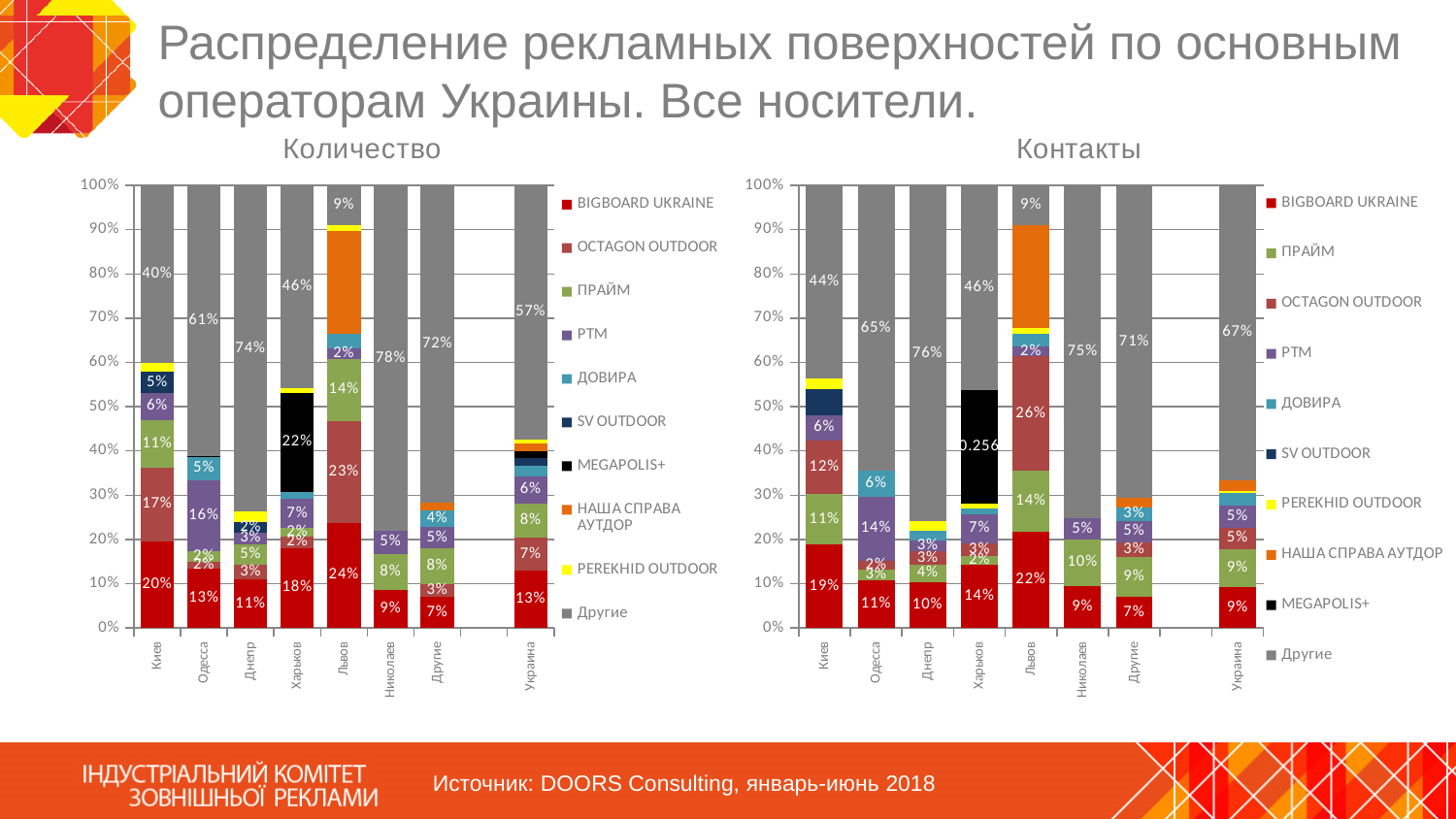
On the 'Количество' chart, what is the BIGBOARD UKRAINE value for Львов? 24% On the 'Количество' chart, what is the value of the 'Другие' segment for Киев? 40% On the 'Количество' chart, which city has the largest 'Другие' segment? Николаев On the 'Контакты' chart, what is the 'Другие' value for Днепр? 76% On the 'Контакты' chart, which category has the smallest 'Другие' segment? Львов On the 'Количество' chart, what is the difference between the 'Другие' values for Николаев and Киев? 38 percentage points On the 'Количество' chart, which has a larger BIGBOARD UKRAINE value, Киев or Одесса? Киев On the 'Контакты' chart, what is the BIGBOARD UKRAINE value for Киев? 19% How many categories are shown on the x axis of the 'Контакты' chart? 8 On the 'Контакты' chart, what is the 'Другие' value for Украина? 67% What type of chart is the 'Контакты' chart? Stacked bar chart How many series does the legend of the 'Количество' chart list? 10